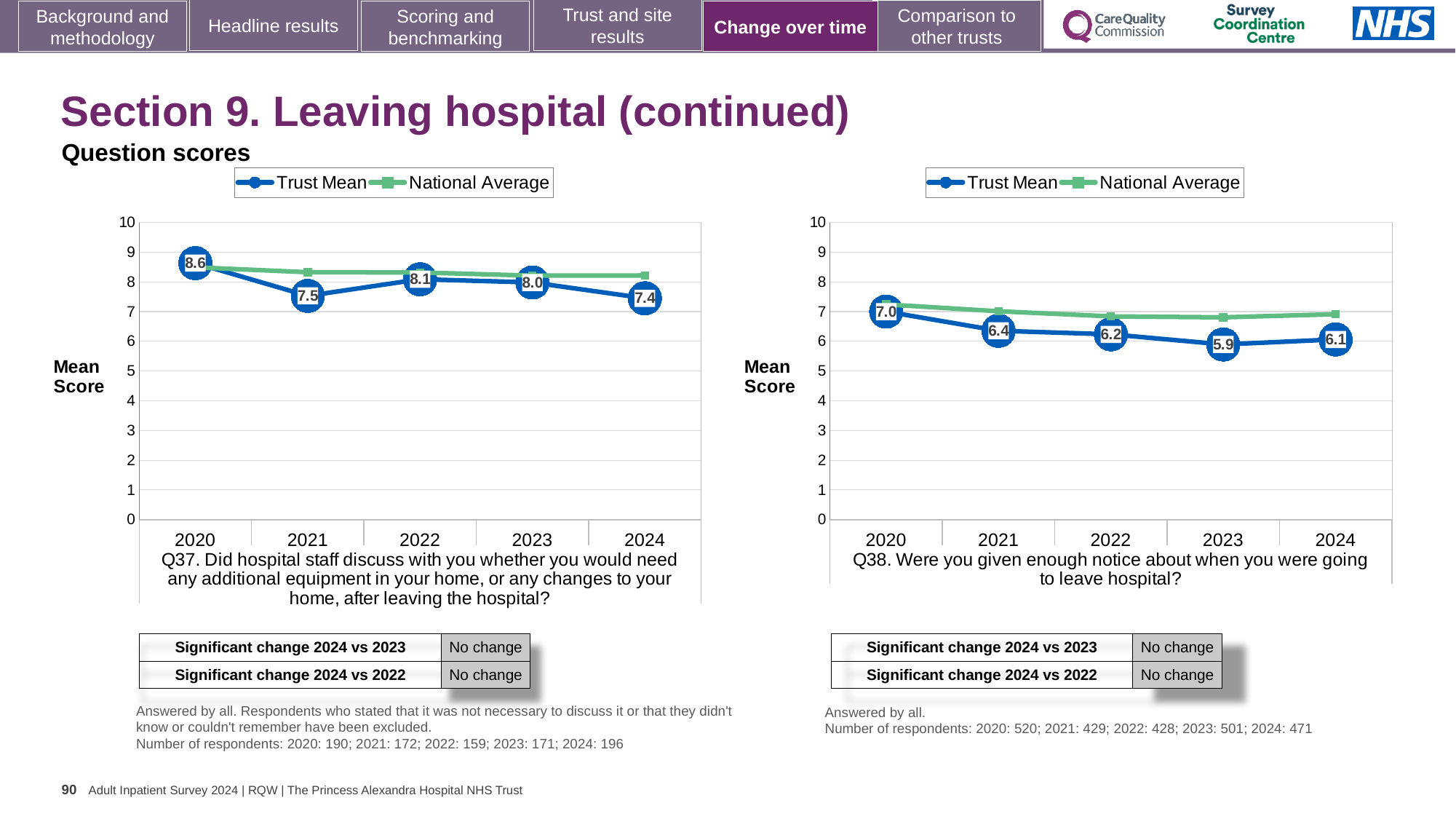
In the Q37 chart (left), what is the Trust Mean score for 2024? 7.4 In the Q38 chart (right), what is the Trust Mean score for 2021? 6.4 In the Q38 chart (right), what is the Trust Mean score for 2023? 5.9 What type of chart is used for Q37 (left)? Line chart In the Q37 chart (left), what is the difference between the Trust Mean scores for 2020 and 2024? 1.2 In the Q38 chart (right), is the Trust Mean score for 2022 larger or smaller than the score for 2024? larger In the Q38 chart (right), is the National Average for 2020 greater or less than 6? greater How many years are shown on the x axis of the Q37 chart (left)? 5 In the Q38 chart (right), which year has the lowest Trust Mean score? 2023 In the Q37 chart (left), what is the Trust Mean score for 2020? 8.6 How many series does the legend of the Q38 chart (right) list? 2 In the Q37 chart (left), which year has the highest Trust Mean score? 2020